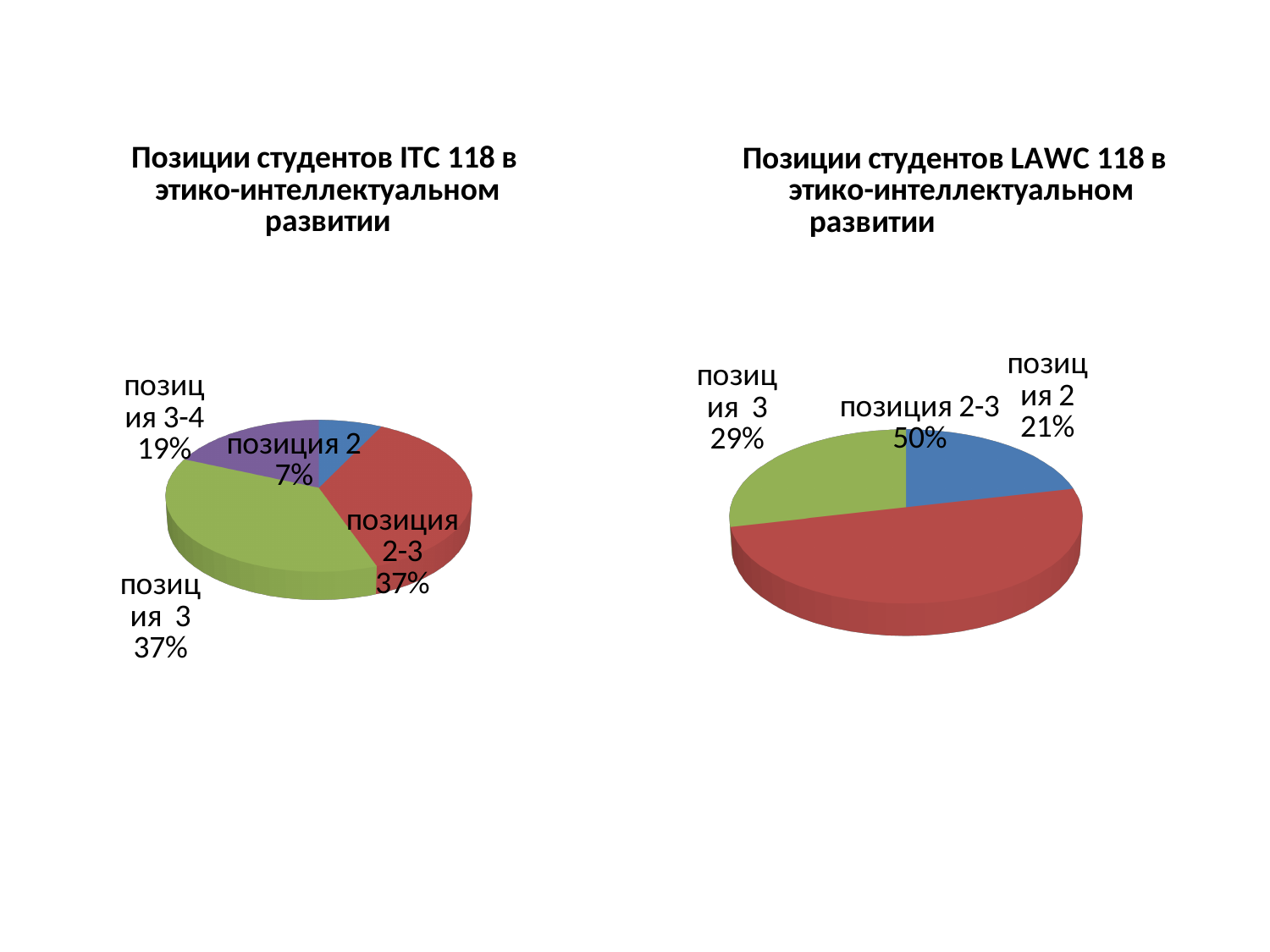
What type of chart is the chart on the right of the slide? Pie chart In the chart titled "Позиции студентов LAWC 118 в этико-интеллектуальном развитии", how many slices does the pie have? 3 In the chart titled "Позиции студентов LAWC 118 в этико-интеллектуальном развитии", what share is labelled for "позиция 2-3"? 50% In the chart titled "Позиции студентов LAWC 118 в этико-интеллектуальном развитии", which category has the largest share? позиция 2-3 In the chart titled "Позиции студентов LAWC 118 в этико-интеллектуальном развитии", which category has the smallest share? позиция 2 In the chart titled "Позиции студентов ITC 118 в этико-интеллектуальном развитии", what share is labelled for "позиция 3-4"? 19% In the chart titled "Позиции студентов ITC 118 в этико-интеллектуальном развитии", what is the difference between the shares of "позиция 3-4" and "позиция 2"? 12% In the chart titled "Позиции студентов ITC 118 в этико-интеллектуальном развитии", which category has the smallest share? позиция 2 In the chart titled "Позиции студентов ITC 118 в этико-интеллектуальном развитии", what share is labelled for "позиция 2"? 7% In the chart titled "Позиции студентов ITC 118 в этико-интеллектуальном развитии", how many slices does the pie have? 4 In the chart titled "Позиции студентов LAWC 118 в этико-интеллектуальном развитии", what share is labelled for "позиция 3"? 29% Which is larger: the share of "позиция 2" in the ITC 118 chart or the share of "позиция 2" in the LAWC 118 chart? LAWC 118